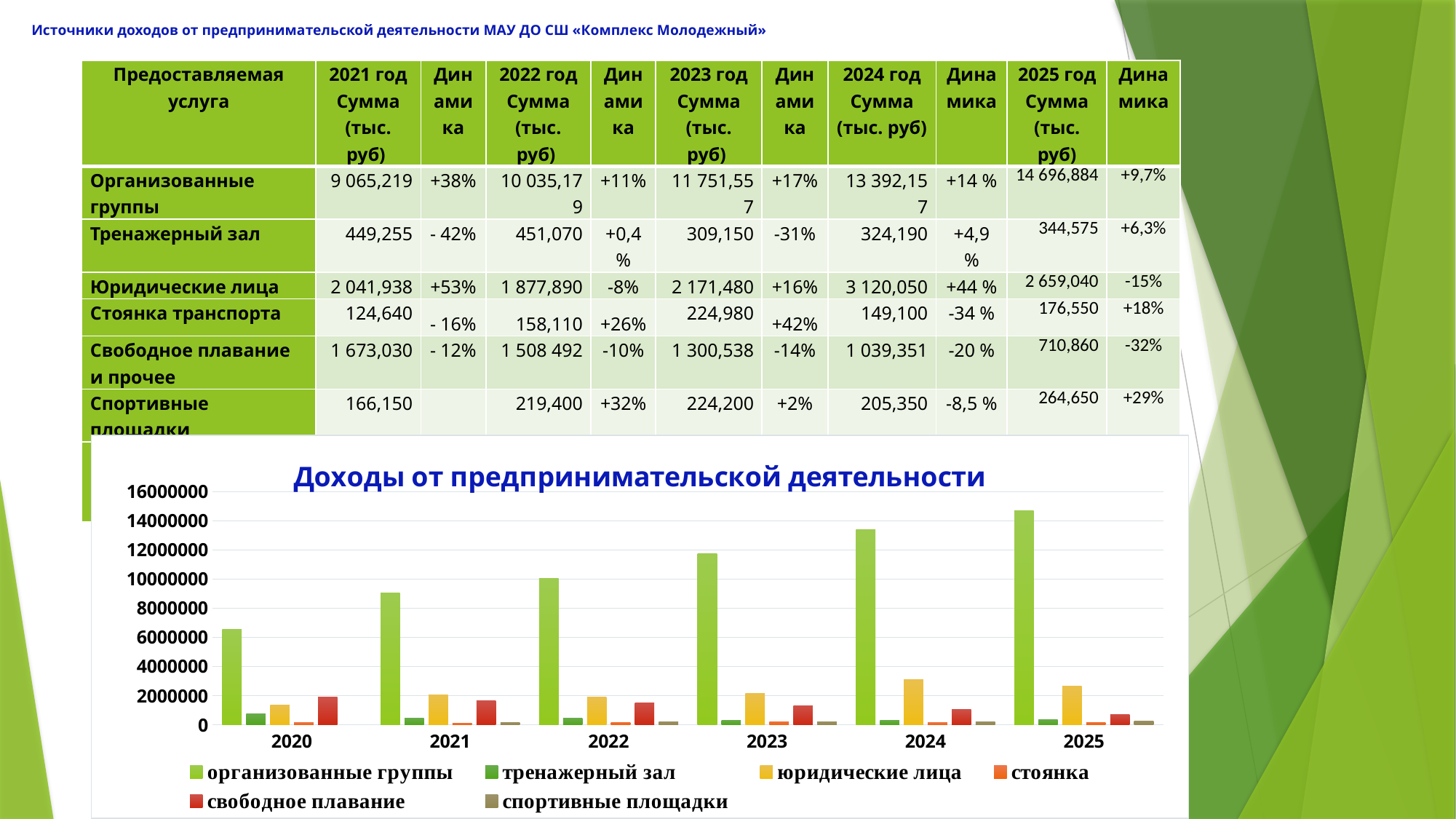
Do the values for организованные группы rise or fall from 2020 to 2025? rise Is the value for организованные группы in 2025 greater or less than 14000000? greater How many series does the chart legend list? 6 In 2024, which is larger: юридические лица or свободное плавание? юридические лица What is the title of the chart? Доходы от предпринимательской деятельности How many years are shown along the x axis of the chart? 6 In which year is the bar for организованные группы the highest? 2025 Which series has the tallest bar in 2025? организованные группы What kind of chart is shown on the slide? bar chart Is the value for организованные группы in 2020 greater or less than 8000000? less Is the value for юридические лица in 2024 greater or less than 2000000? greater In which year is the bar for организованные группы the lowest? 2020